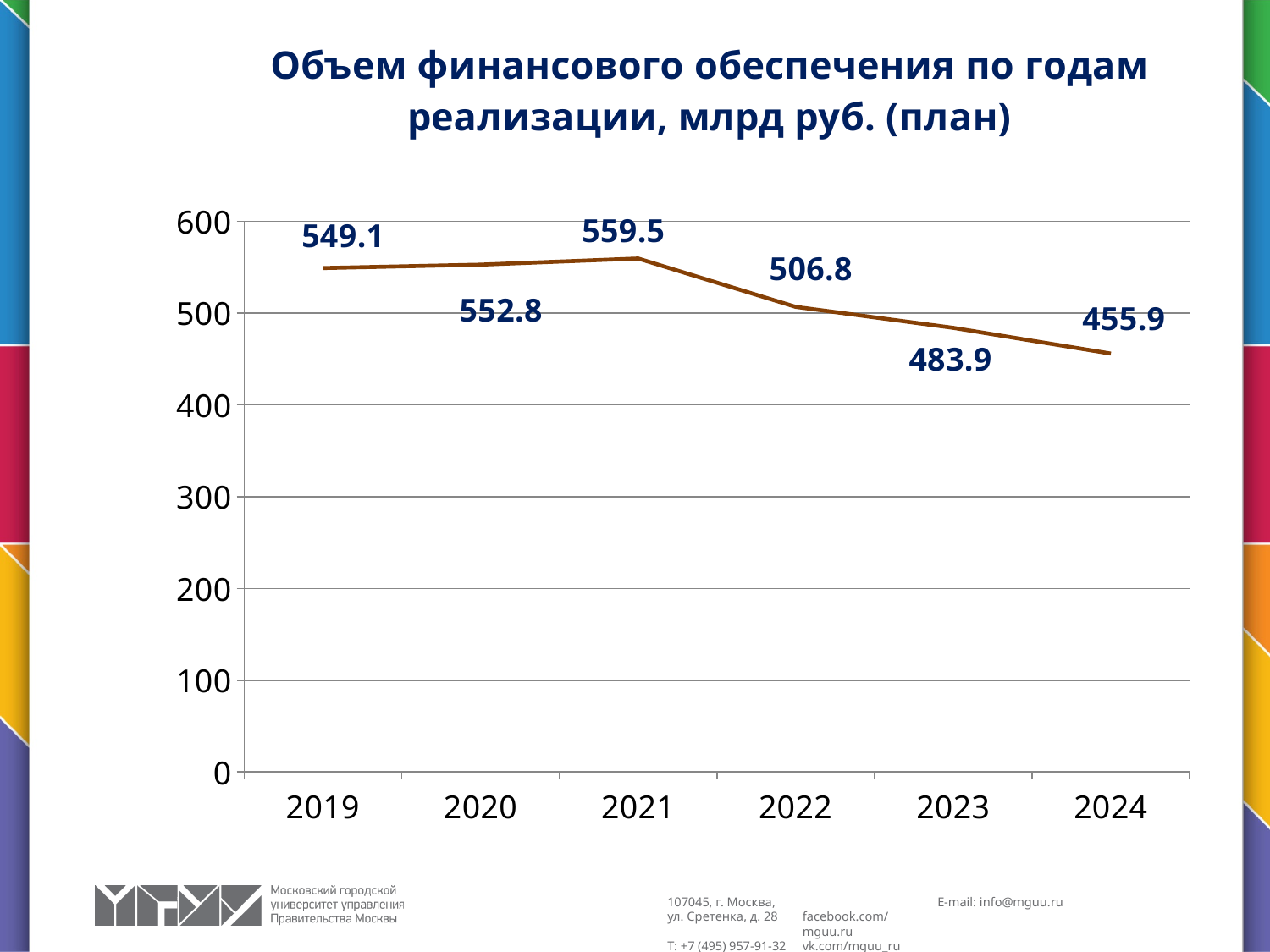
What kind of chart is shown on the slide? line chart What is the value for 2022? 506.8 How many years are plotted on the x axis? 6 Which year has the highest value? 2021 What is the value for 2024? 455.9 Which is larger, the value for 2020 or the value for 2023? 2020 Which year has the lowest value? 2024 What is the difference between the values for 2022 and 2023? 22.9 What is the value for 2019? 549.1 What is the difference between the values for 2021 and 2024? 103.6 Is the value for 2023 greater or less than 500? less Do the values rise or fall from 2021 to 2024? fall